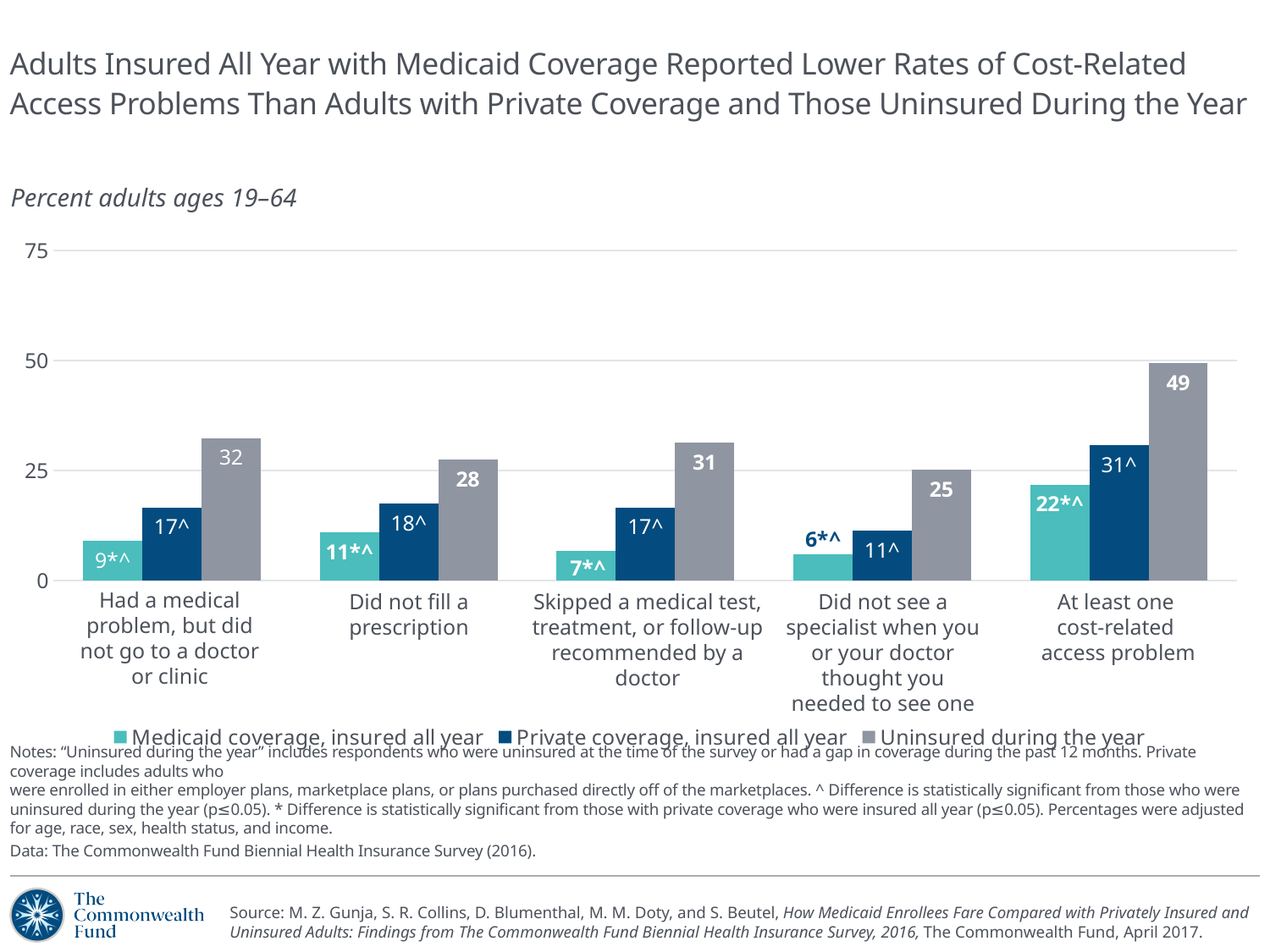
What is the value for Uninsured during the year for 'At least one cost-related access problem'? 49 What kind of chart is shown on the slide? Bar chart How many series does the legend list? 3 For 'Had a medical problem, but did not go to a doctor or clinic', which is larger: the Private coverage value or the Uninsured during the year value? Uninsured during the year What is the value for Medicaid coverage, insured all year for 'Did not fill a prescription'? 11*^ Which category has the lowest value for Medicaid coverage, insured all year? Did not see a specialist when you or your doctor thought you needed to see one What is the difference between the Uninsured during the year value and the Medicaid coverage value for 'At least one cost-related access problem'? 27 Which category has the highest value for Uninsured during the year? At least one cost-related access problem What is the value for Private coverage, insured all year for 'Did not see a specialist when you or your doctor thought you needed to see one'? 11^ Is the value for Uninsured during the year for 'Did not fill a prescription' greater or less than 25? greater What is the value for Uninsured during the year for 'Skipped a medical test, treatment, or follow-up recommended by a doctor'? 31 How many categories are shown on the x axis? 5